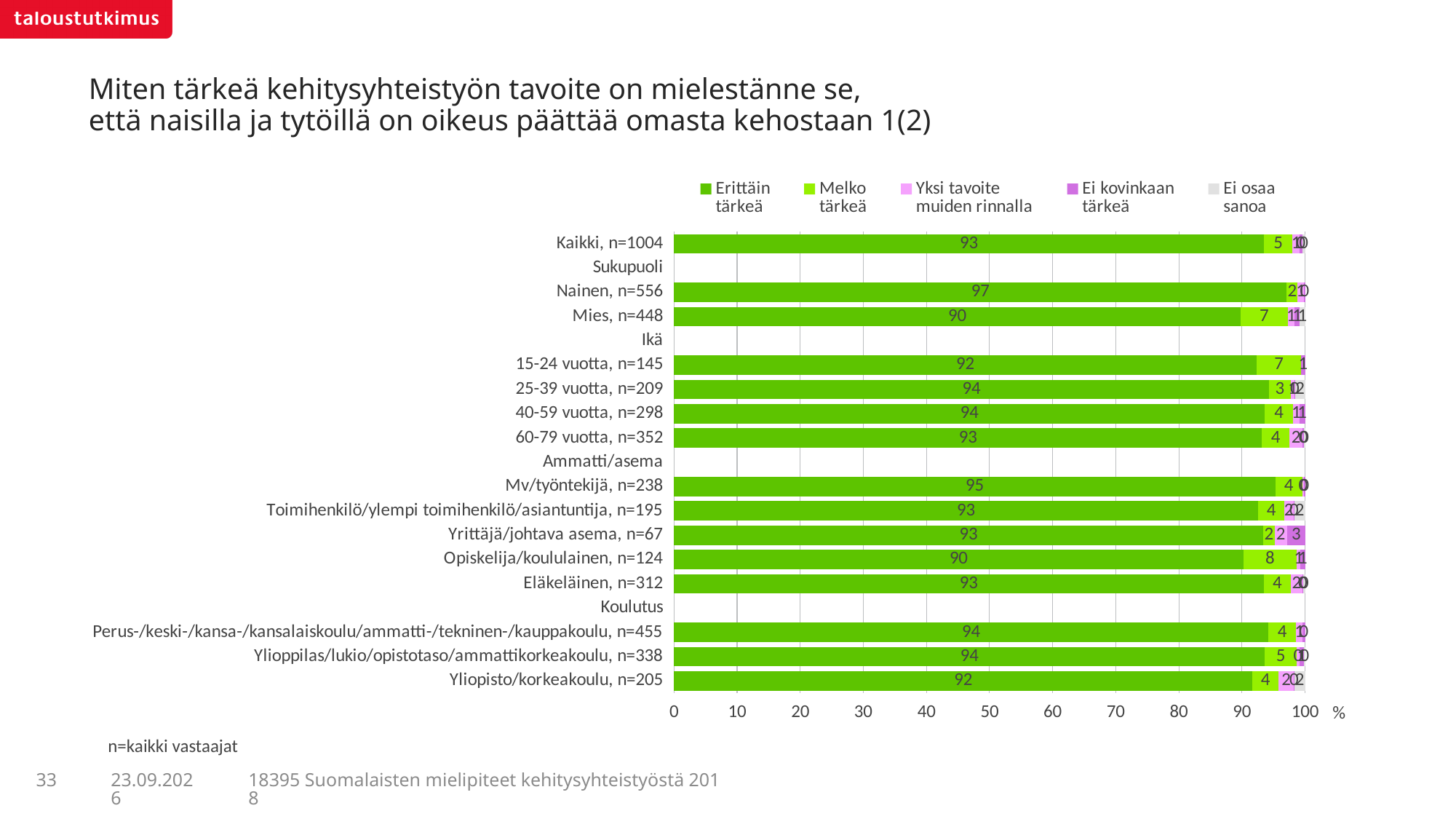
What kind of chart is shown on the slide? Stacked bar chart Is the "Erittäin tärkeä" value for Mv/työntekijä, n=238 greater or less than 90? greater Which has a larger "Melko tärkeä" value, Mies, n=448 or Nainen, n=556? Mies, n=448 What percentage of all respondents (Kaikki, n=1004) answered "Erittäin tärkeä"? 93 What is the "Melko tärkeä" value for Opiskelija/koululainen, n=124? 8 How many series does the legend list? 5 What is the difference between the "Erittäin tärkeä" values for Nainen, n=556 and Mies, n=448? 7 What is the "Erittäin tärkeä" value for Nainen, n=556? 97 What is the "Melko tärkeä" value for Mies, n=448? 7 Which group has the highest "Erittäin tärkeä" value? Nainen, n=556 Which group has the highest "Melko tärkeä" value? Opiskelija/koululainen, n=124 What is the "Erittäin tärkeä" value for Opiskelija/koululainen, n=124? 90